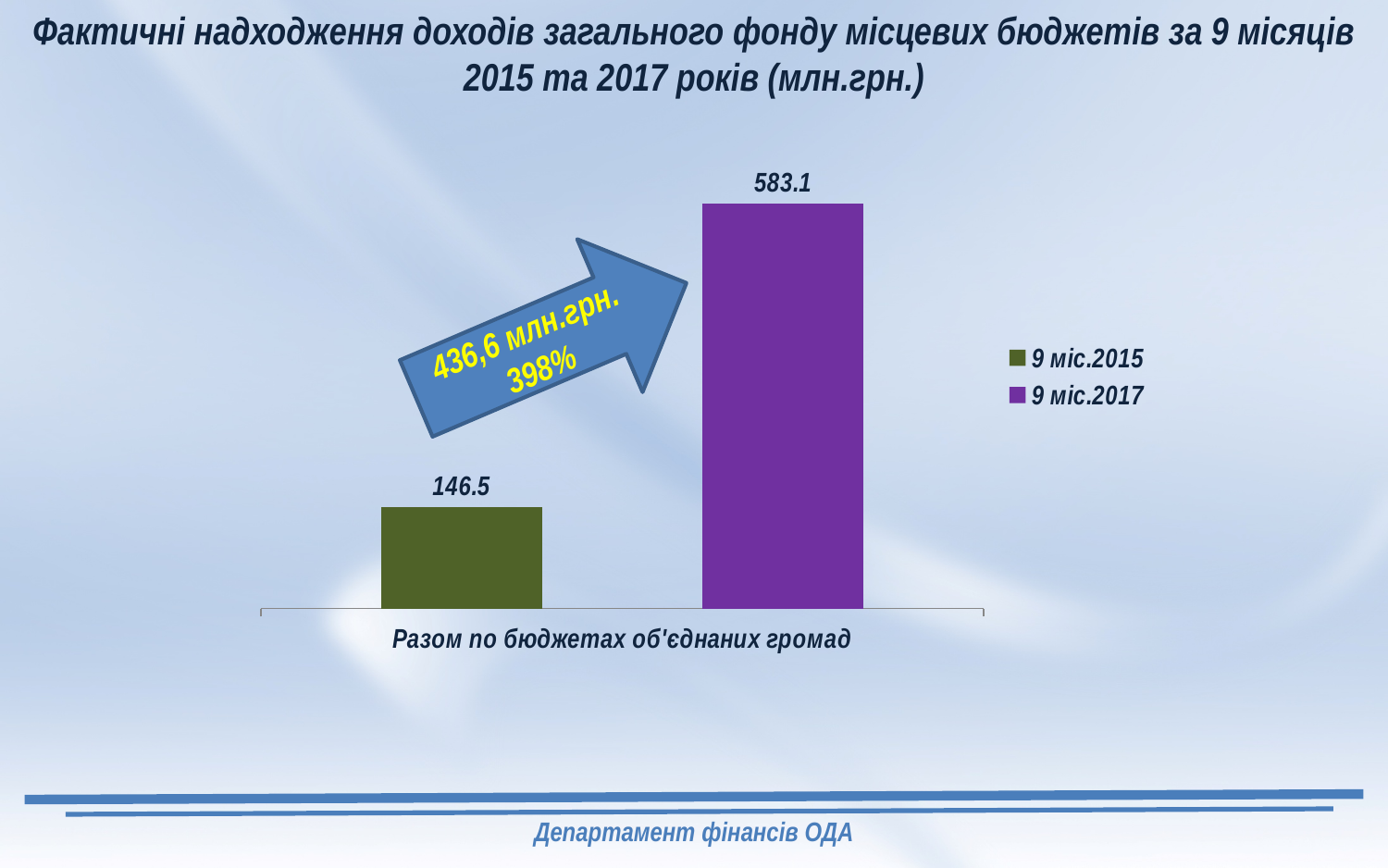
What is the value for the series "9 міс.2017"? 583.1 Which series has the lowest value on the chart? 9 міс.2015 Which series has the highest value on the chart? 9 міс.2017 What colour is the bar for the series "9 міс.2017"? Purple How many categories are shown on the x axis? 1 What percentage is printed on the arrow between the two bars? 398% What is the category label shown on the x axis? Разом по бюджетах об'єднаних громад What is the difference between the values for "9 міс.2017" and "9 міс.2015"? 436.6 What kind of chart is shown on the slide? Bar chart What is the value for the series "9 міс.2015"? 146.5 How many series does the legend list? 2 Which series has the higher value, "9 міс.2015" or "9 міс.2017"? 9 міс.2017